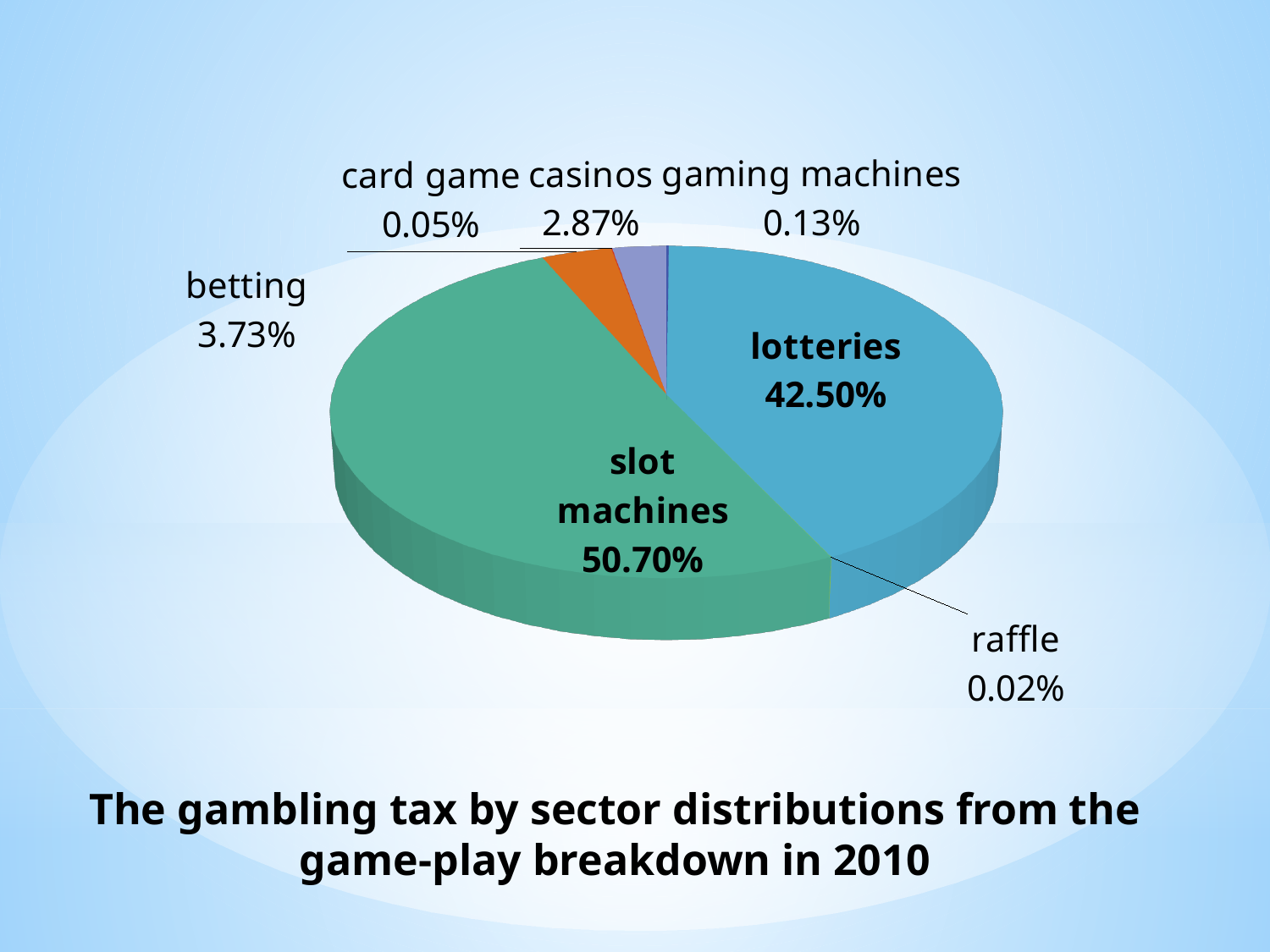
What is the value shown for casinos? 2.87% What share of the gambling tax do lotteries account for? 42.50% What is the value shown for betting? 3.73% What is the difference between the shares of slot machines and lotteries? 8.20% What type of chart is shown on the slide? pie chart Which is larger, the share for betting or the share for casinos? betting Which sector has the largest share of the pie? slot machines What is the value shown for gaming machines? 0.13% What share of the gambling tax do slot machines account for? 50.70% What is the value shown for raffle? 0.02% Which sector has the smallest share of the pie? raffle How many sectors are shown in the pie chart? 7